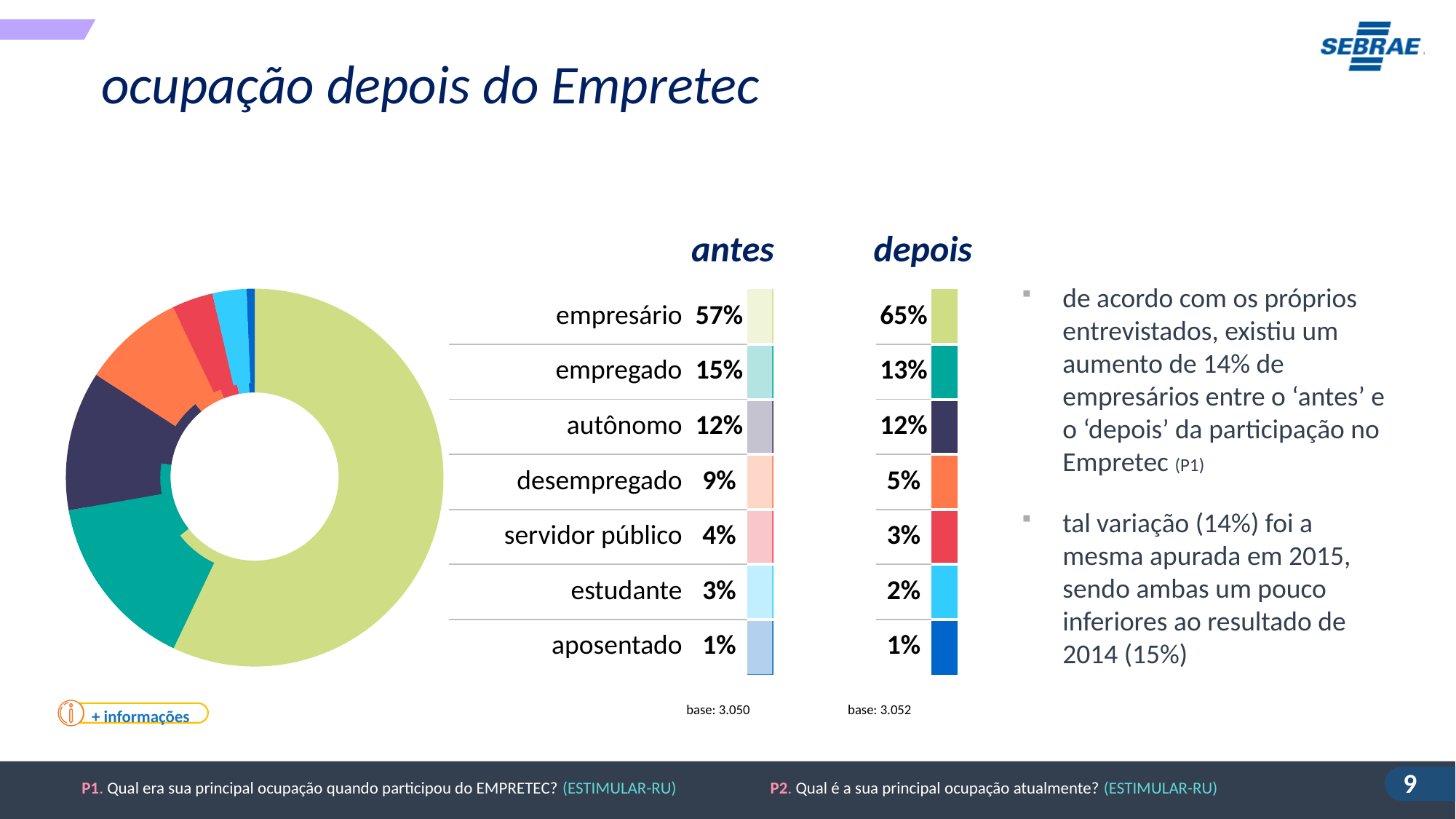
Which occupation has the lowest 'depois' value? aposentado What is the 'antes' value for desempregado? 9% Which occupation has the highest 'antes' value? empresário What is the 'depois' value for empregado? 13% What kind of chart is shown on the left of the slide? donut (pie) chart What is the difference between the 'depois' and 'antes' values for empresário? 8% What is the 'depois' value for empresário? 65% What is the base (sample size) for the 'depois' series? 3.052 How many occupation categories are shown? 7 Which is larger, the 'antes' value for empregado or the 'depois' value for empregado? antes (15%) How many series (time points) are compared in the chart? 2 What is the difference between the 'antes' and 'depois' values for desempregado? 4%